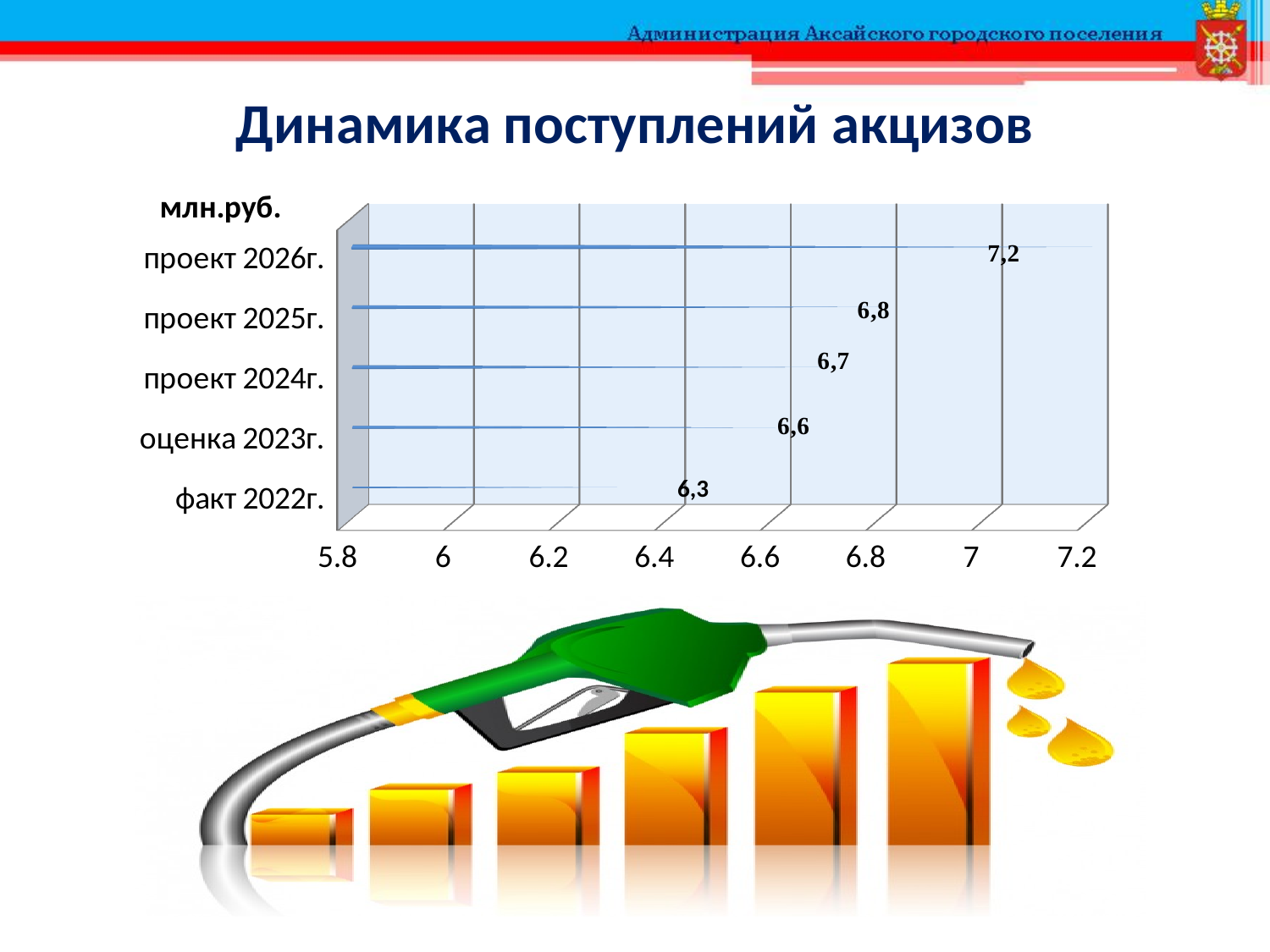
What is the difference between the values for проект 2026г. and факт 2022г.? 0,9 Which is larger, the value for проект 2025г. or the value for проект 2024г.? проект 2025г. What is the value for оценка 2023г.? 6,6 How many categories are shown in the chart? 5 Which category has the lowest value? факт 2022г. What is the value for факт 2022г.? 6,3 What is the difference between the values for проект 2025г. and оценка 2023г.? 0,2 Which category has the highest value? проект 2026г. What is the value for проект 2024г.? 6,7 What is the title of the chart? Динамика поступлений акцизов What is the value for проект 2026г.? 7,2 What kind of chart is shown on the slide? bar chart